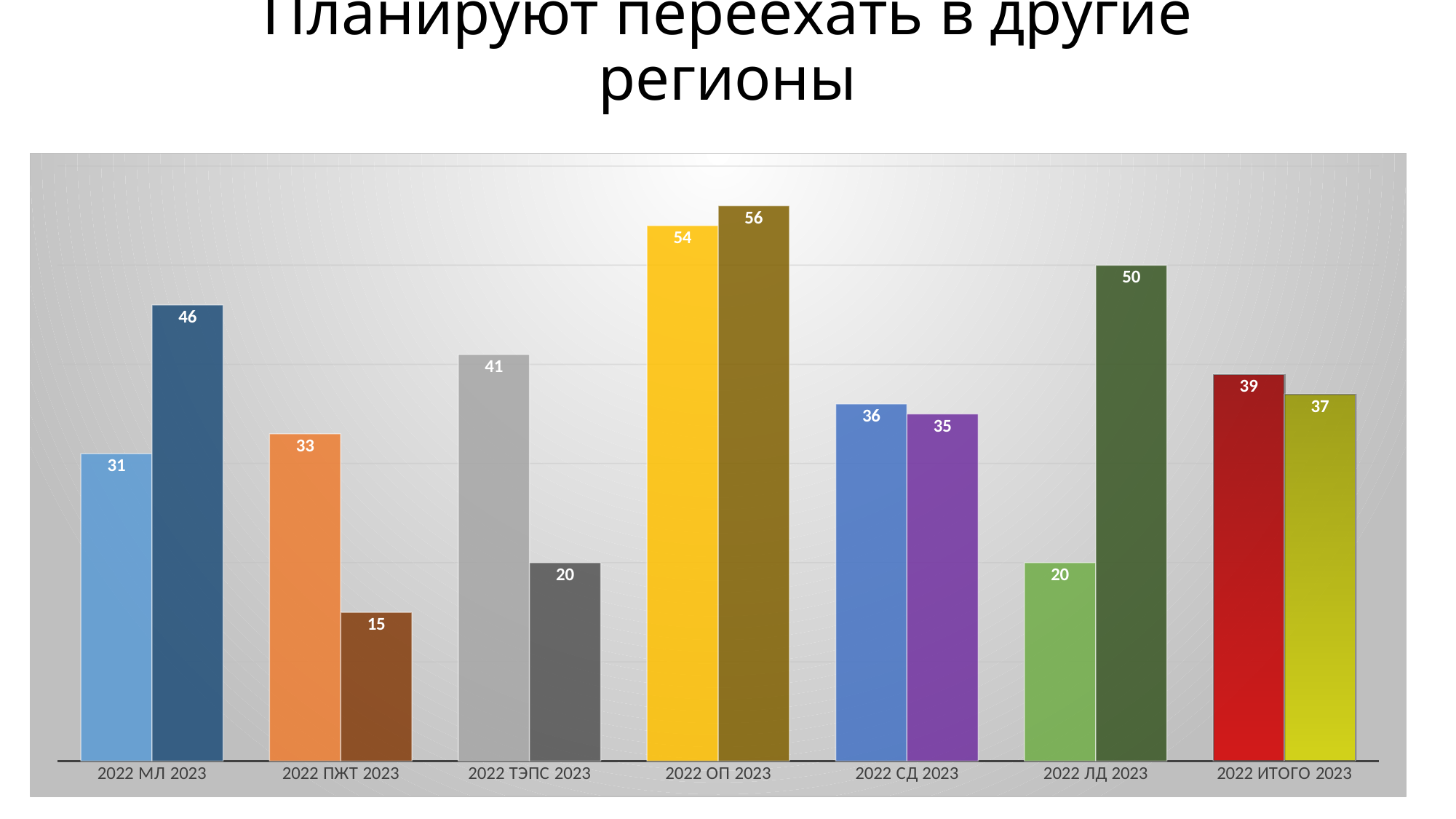
What is the 2023 value for ПЖТ? 15 What is the 2022 value for МЛ? 31 What type of chart is shown on the slide? Bar chart Which group has the highest 2023 value? ОП What is the 2022 value for ИТОГО? 39 Which group has the lowest 2022 value? ЛД Which is larger for МЛ: the 2022 value or the 2023 value? 2023 What is the difference between the 2022 and 2023 values for ТЭПС? 21 How many groups are shown on the x axis? 7 What is the title of the chart? Планируют переехать в другие регионы What is the 2023 value for ЛД? 50 What is the difference between the 2023 and 2022 values for ЛД? 30